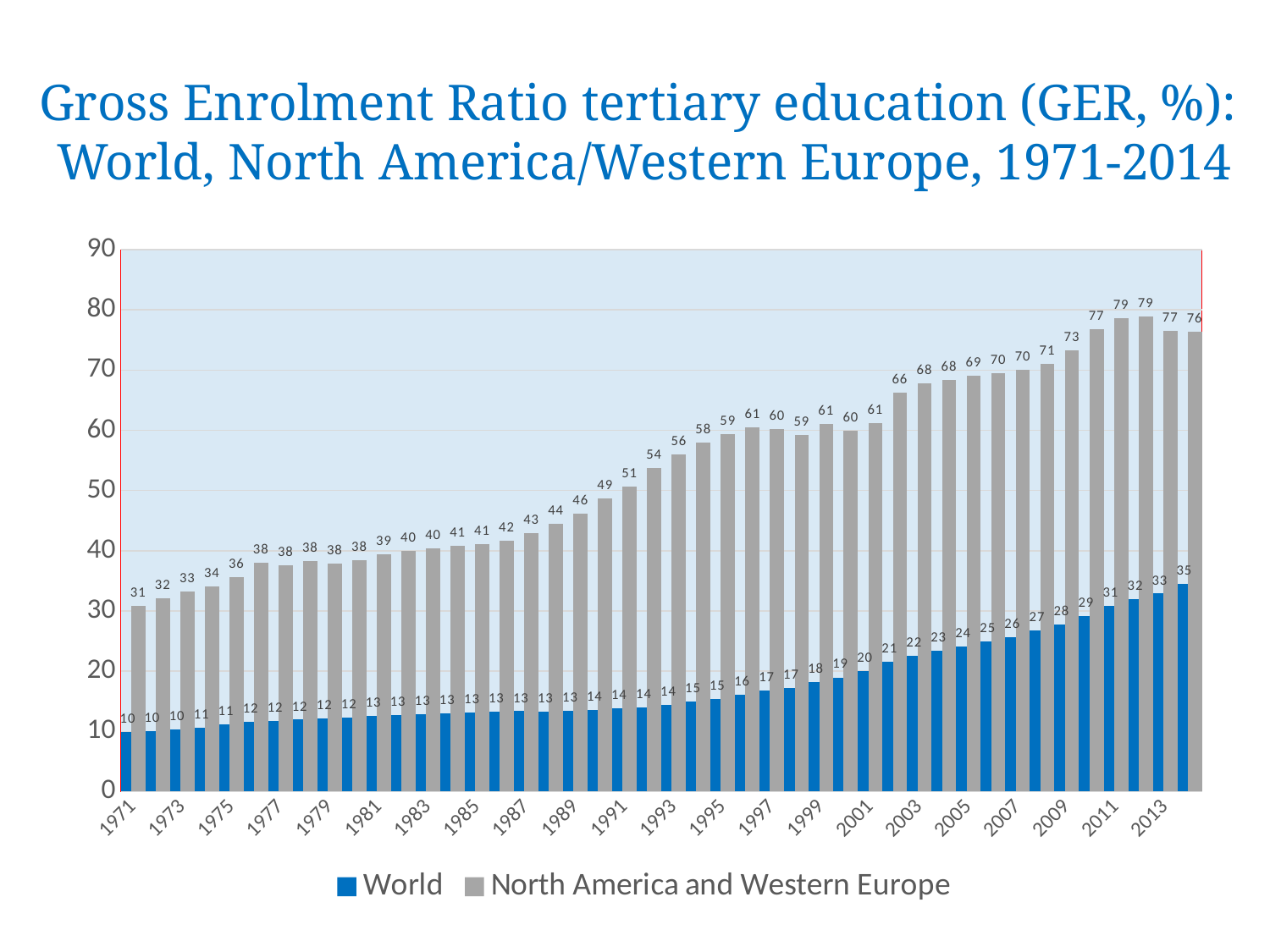
What is the North America and Western Europe value for 1991? 51 What kind of chart is shown on the slide? Bar chart By how much did the World value increase from 1971 to 2013? 23 What is the North America and Western Europe value for 2013? 77 How many series does the legend list? 2 For North America and Western Europe, which year has the larger value, 1995 or 2005? 2005 What is the World value for 2009? 28 Do the World values generally rise or fall from 1971 to 2014? Rise What is the highest value shown for North America and Western Europe? 79 In 2013, how much higher is the North America and Western Europe value than the World value? 44 What is the lowest value shown for the World series? 10 What is the World value for 1971? 10